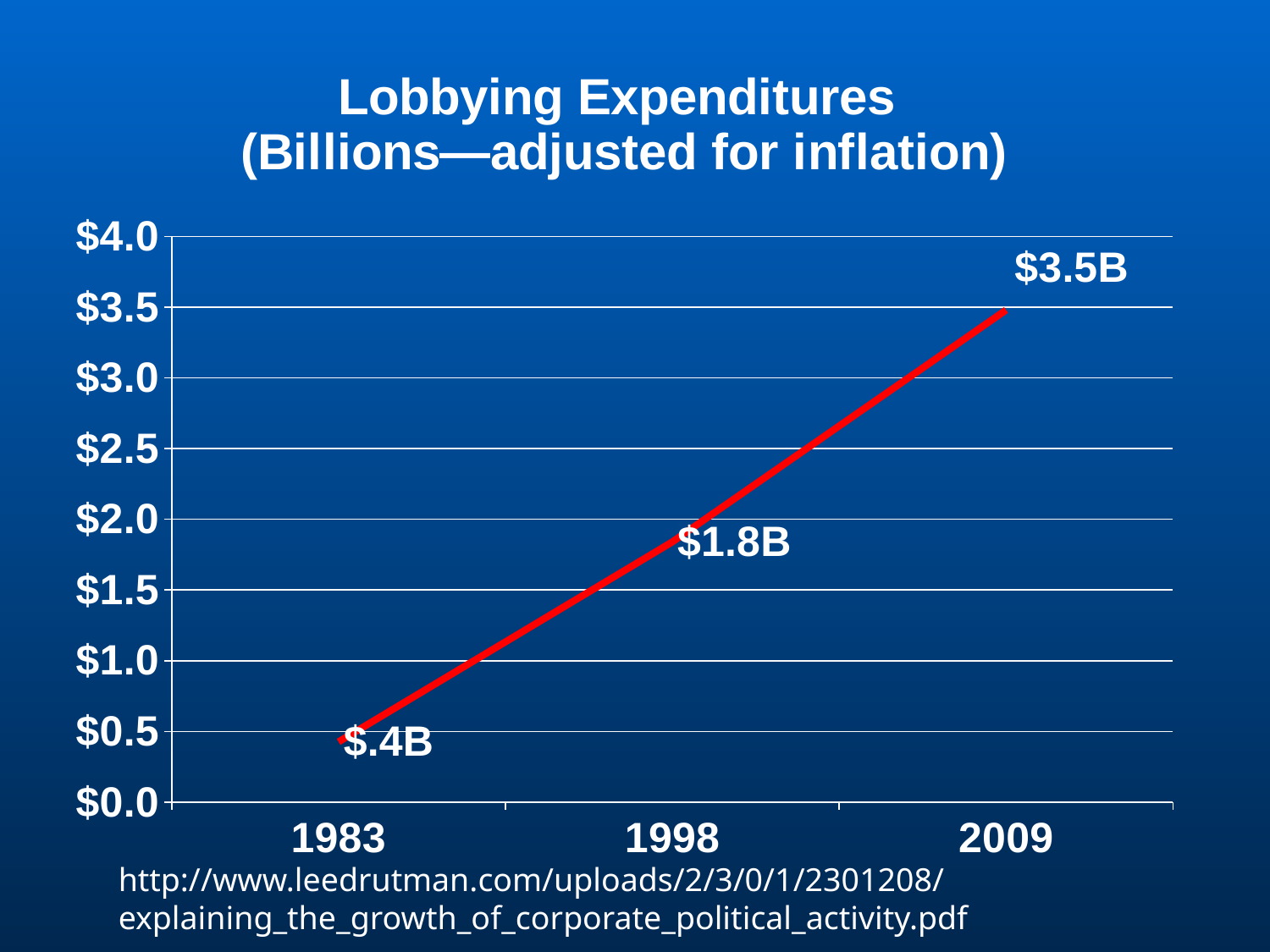
What is the lobbying expenditure value shown for 2009? $3.5B What kind of chart is shown on the slide? line chart Which year has the highest lobbying expenditure? 2009 How many years are plotted on the chart? 3 Which is larger, the value for 1998 or the value for 1983? 1998 Is the value for 2009 greater or less than $3.0? greater Which year has the lowest lobbying expenditure? 1983 What is the difference between the 2009 and 1998 values? $1.7B What is the lobbying expenditure value shown for 1983? $.4B Do the values rise or fall from 1983 to 2009? rise What is the lobbying expenditure value shown for 1998? $1.8B What is the difference between the 1998 and 1983 values? $1.4B